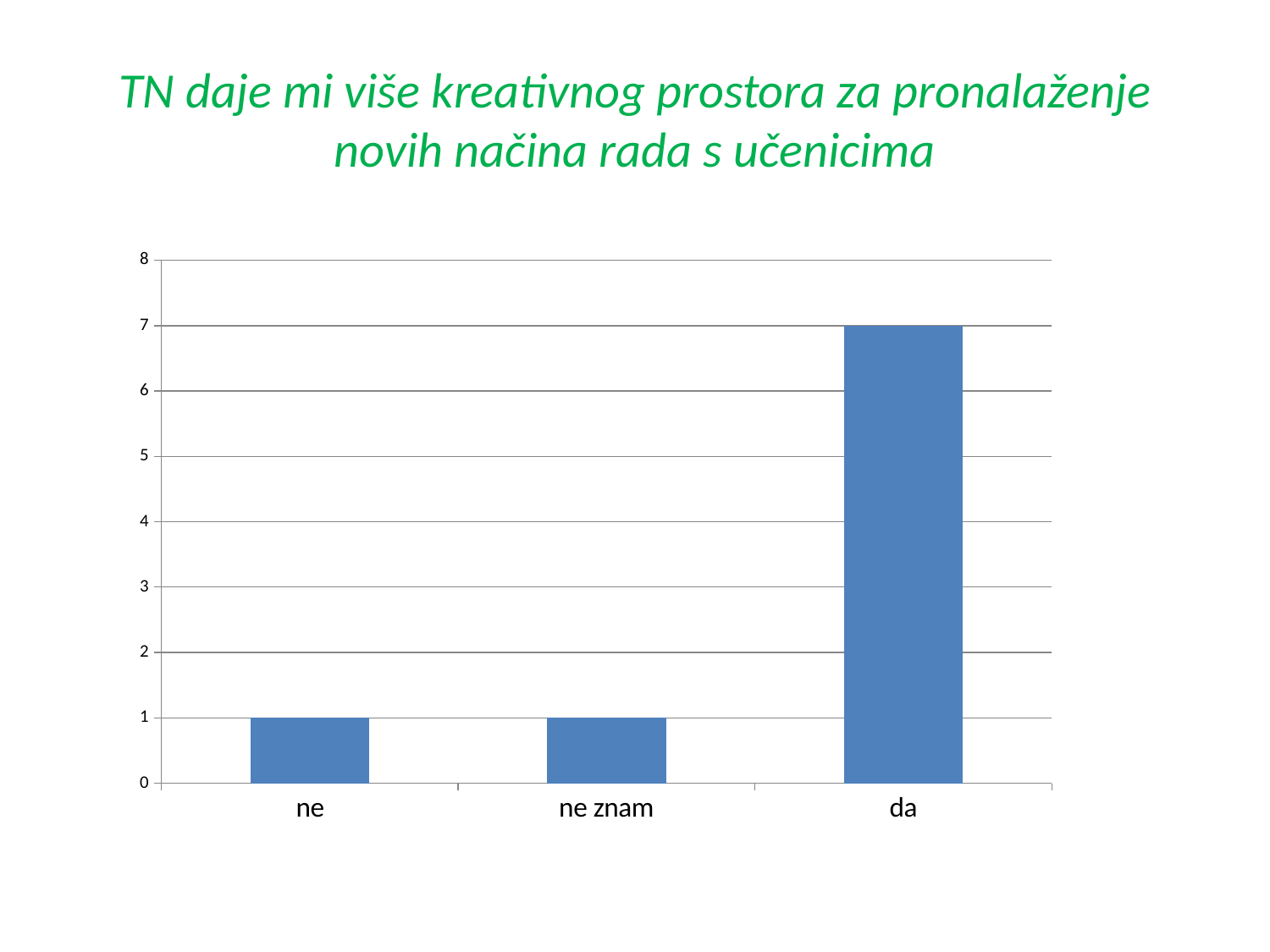
Is the value for "da" greater or less than 5? greater Is the value for "ne" greater or less than 3? less What is the maximum value shown on the vertical axis? 8 What is the value for "ne"? 1 Which category has the highest value? da Which is larger, the value for "da" or the value for "ne znam"? da How many categories are shown on the x axis? 3 What is the value for "da"? 7 What is the value for "ne znam"? 1 What is the title of the slide? TN daje mi više kreativnog prostora za pronalaženje novih načina rada s učenicima What kind of chart is shown on the slide? bar chart What is the difference between the values for "da" and "ne"? 6